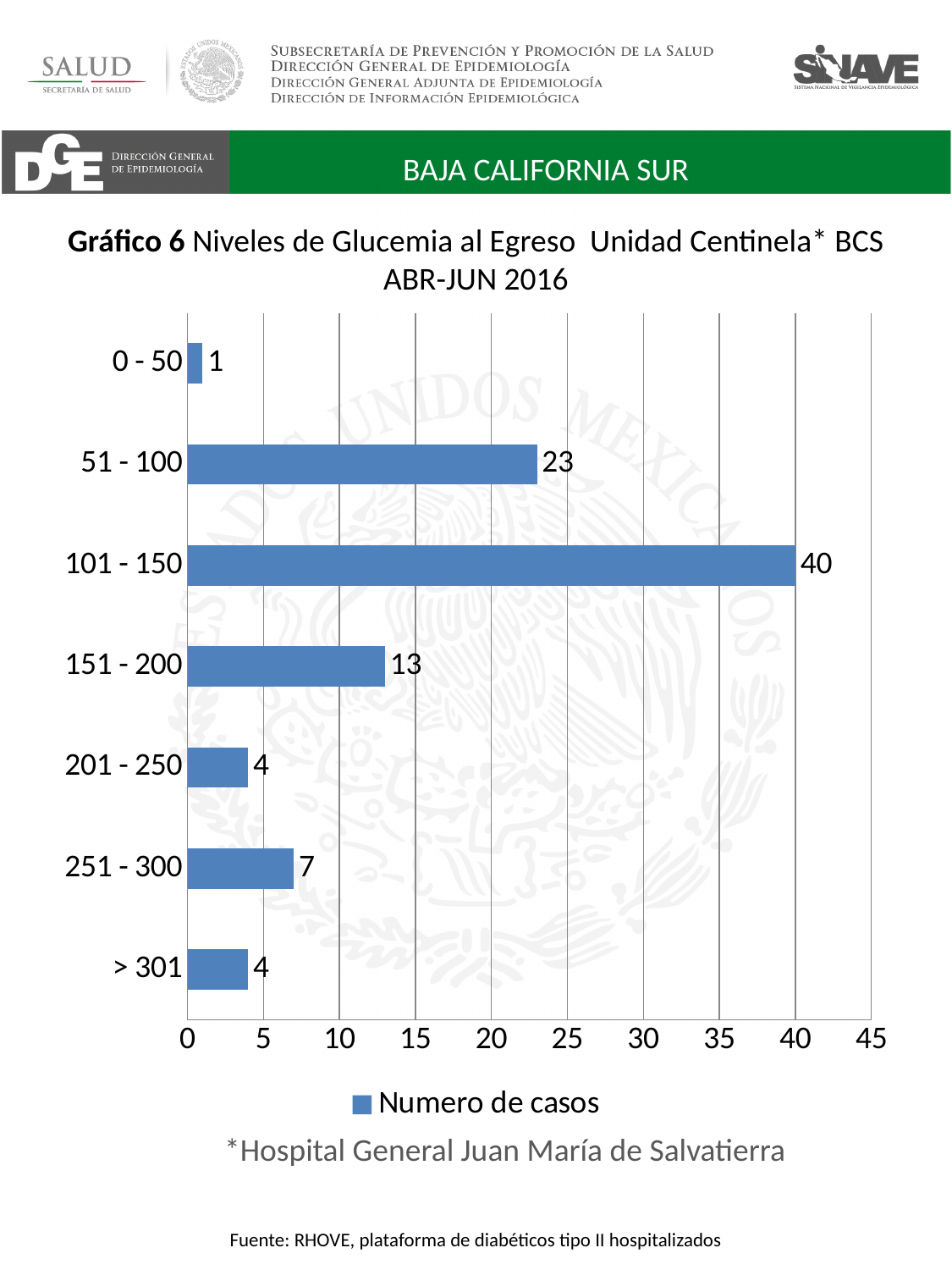
What is the number of cases for the 251 - 300 category? 7 What is the legend entry for the series in the chart? Numero de casos What is the difference in number of cases between the 101 - 150 and 51 - 100 categories? 17 How many series does the legend list? 1 Which glucose level category has the lowest number of cases? 0 - 50 What is the total number of cases across the 201 - 250 and > 301 categories? 8 How many glucose level categories are shown in the chart? 7 Which has more cases, the 151 - 200 category or the 251 - 300 category? 151 - 200 What is the number of cases for the 51 - 100 category? 23 Which glucose level category has the highest number of cases? 101 - 150 What kind of chart is shown on the slide? Bar chart What is the number of cases for the 101 - 150 glucose level category? 40